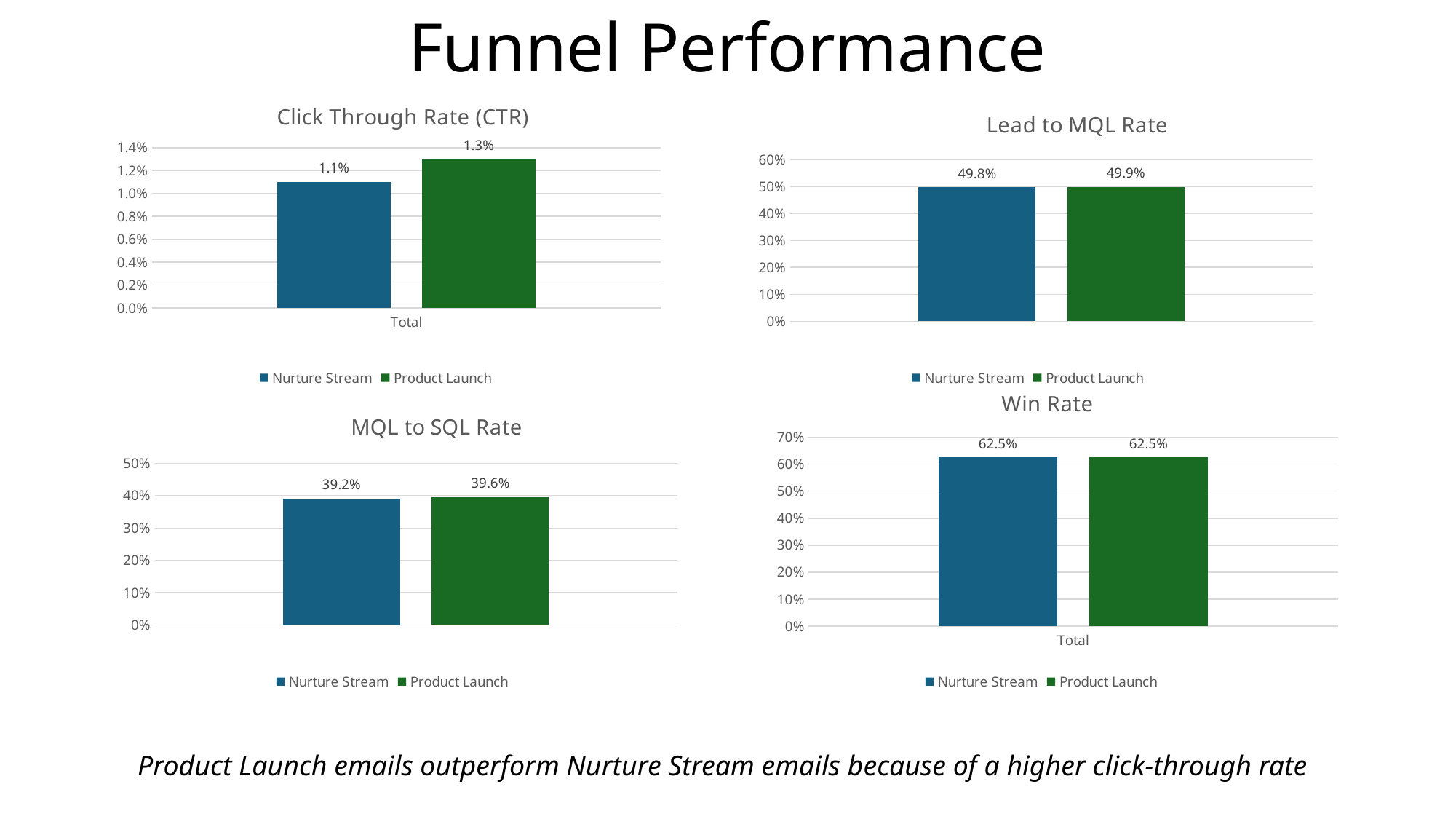
In the Lead to MQL Rate chart, what is the value for Product Launch? 49.9% How many series does the legend of the MQL to SQL Rate chart list? 2 In the Lead to MQL Rate chart, what is the value for Nurture Stream? 49.8% In the Click Through Rate (CTR) chart, what is the difference between the Product Launch and Nurture Stream values? 0.2% In the Win Rate chart, what is the value for Nurture Stream? 62.5% In the Click Through Rate (CTR) chart, which series has the higher value, Nurture Stream or Product Launch? Product Launch In the Click Through Rate (CTR) chart, what is the value for Product Launch? 1.3% In the Click Through Rate (CTR) chart, what is the value for Nurture Stream? 1.1% In the MQL to SQL Rate chart, what is the difference between the Product Launch and Nurture Stream values? 0.4% In the Win Rate chart, is the value for Product Launch greater or less than 50%? greater What kind of chart is the Win Rate chart? bar chart In the MQL to SQL Rate chart, what is the value for Product Launch? 39.6%